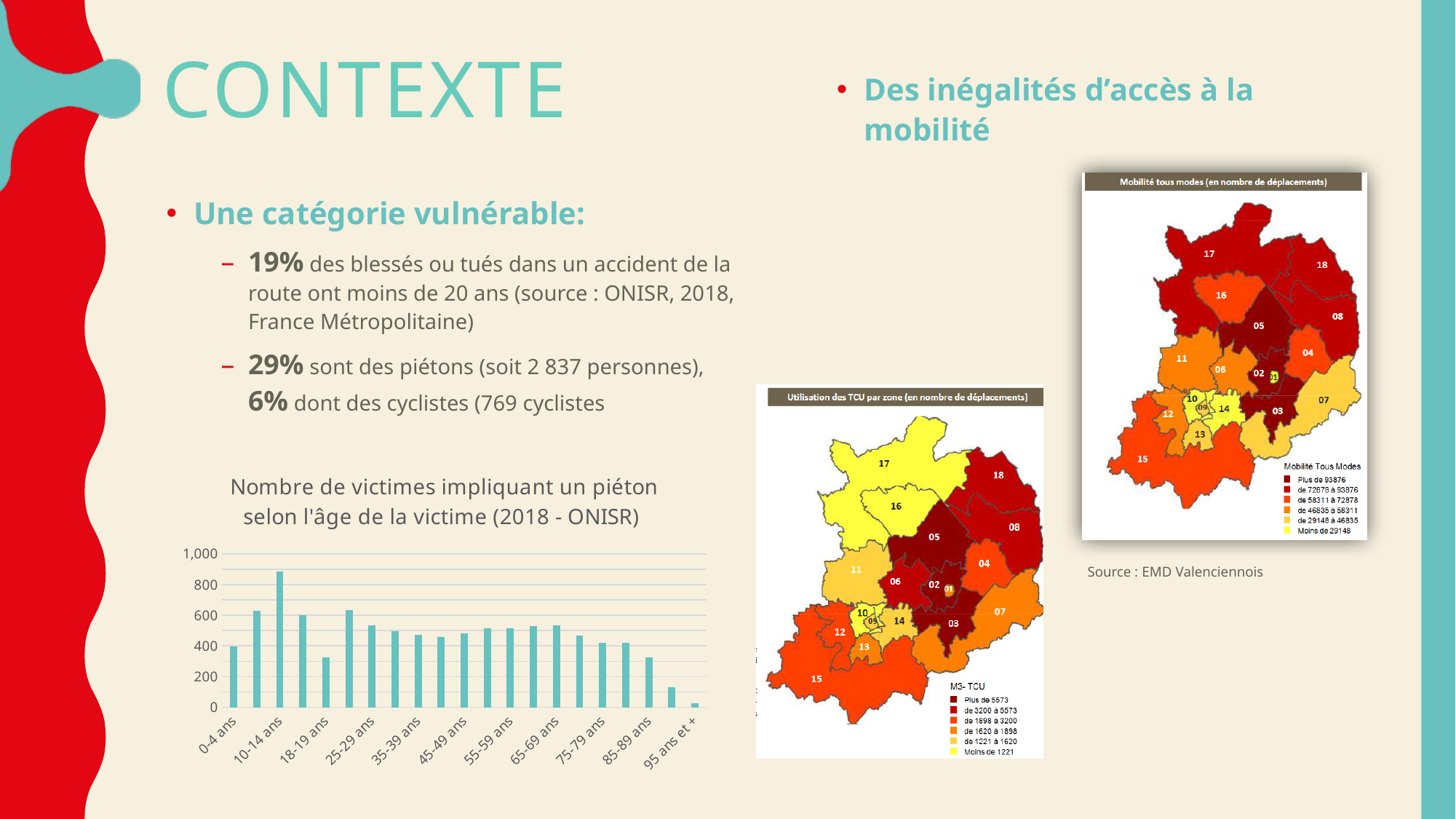
In the bar chart, do the values rise or fall from 65-69 ans to 95 ans et +? fall In the bar chart, which age group has the lowest number of victims? 95 ans et + In the bar chart, which age group has the highest number of victims? 10-14 ans What is the title of the bar chart on the slide? Nombre de victimes impliquant un piéton selon l'âge de la victime (2018 - ONISR) In the bar chart, which is larger: the value for 10-14 ans or the value for 18-19 ans? 10-14 ans In the bar chart, which is larger: the value for 25-29 ans or the value for 85-89 ans? 25-29 ans In the bar chart, is the value for 85-89 ans greater or less than 400? less In the bar chart, is the value for 95 ans et + greater or less than 200? less In the bar chart, is the value for 10-14 ans greater or less than 800? greater What kind of chart is 'Nombre de victimes impliquant un piéton selon l'âge de la victime (2018 - ONISR)'? bar chart